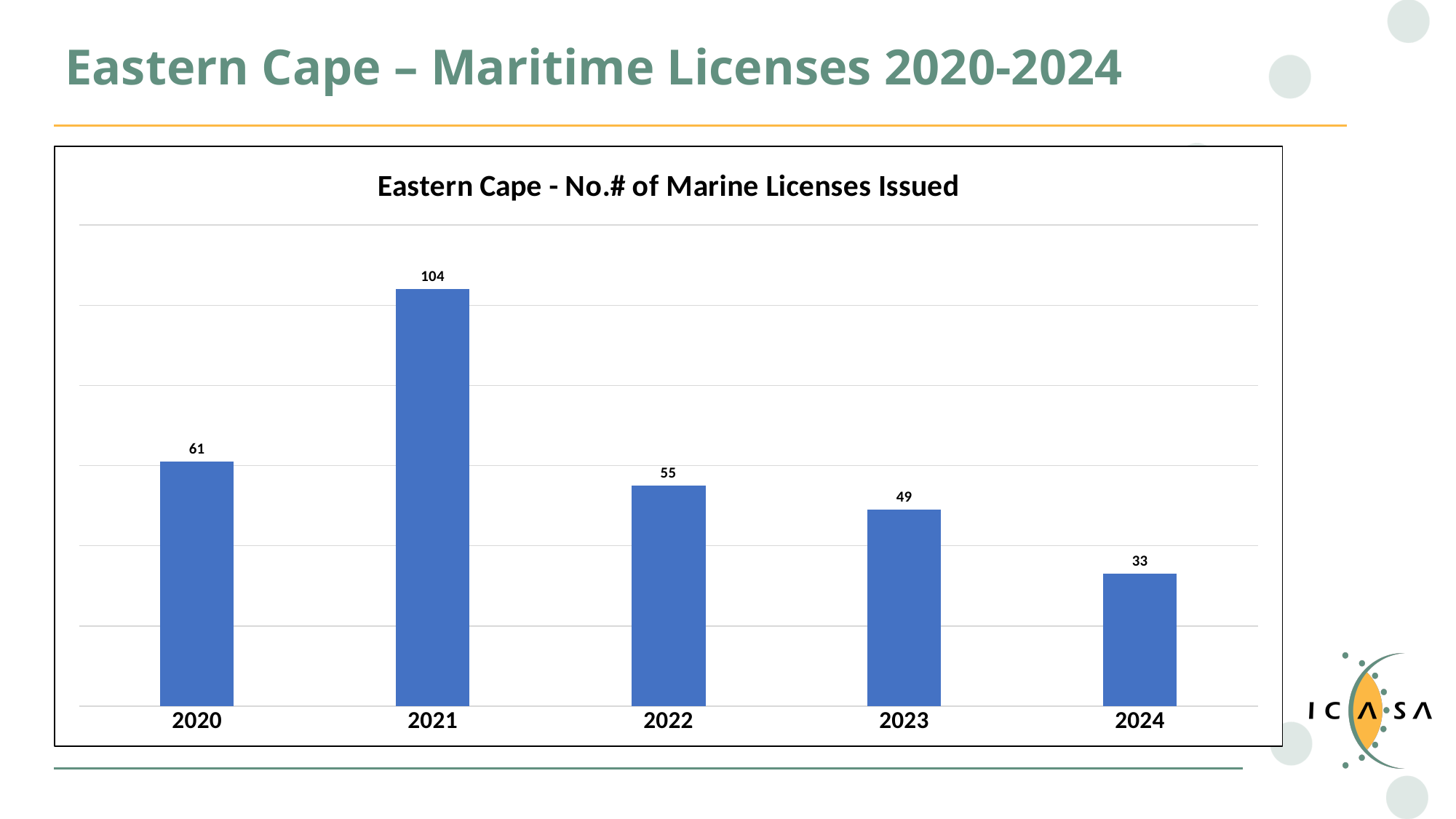
Which year has the lowest number of marine licenses issued? 2024 What kind of chart is shown on the slide? Bar chart What is the title of the chart? Eastern Cape - No.# of Marine Licenses Issued From 2021 to 2024, do the values rise or fall? Fall How many years are shown on the x axis of the chart? 5 What is the value shown for 2024? 33 How many marine licenses were issued in the Eastern Cape in 2021? 104 What is the difference between the values for 2021 and 2020? 43 Which year has the highest number of marine licenses issued? 2021 What is the value shown for 2020? 61 What is the difference between the values for 2022 and 2023? 6 Which year has a larger value, 2020 or 2022? 2020